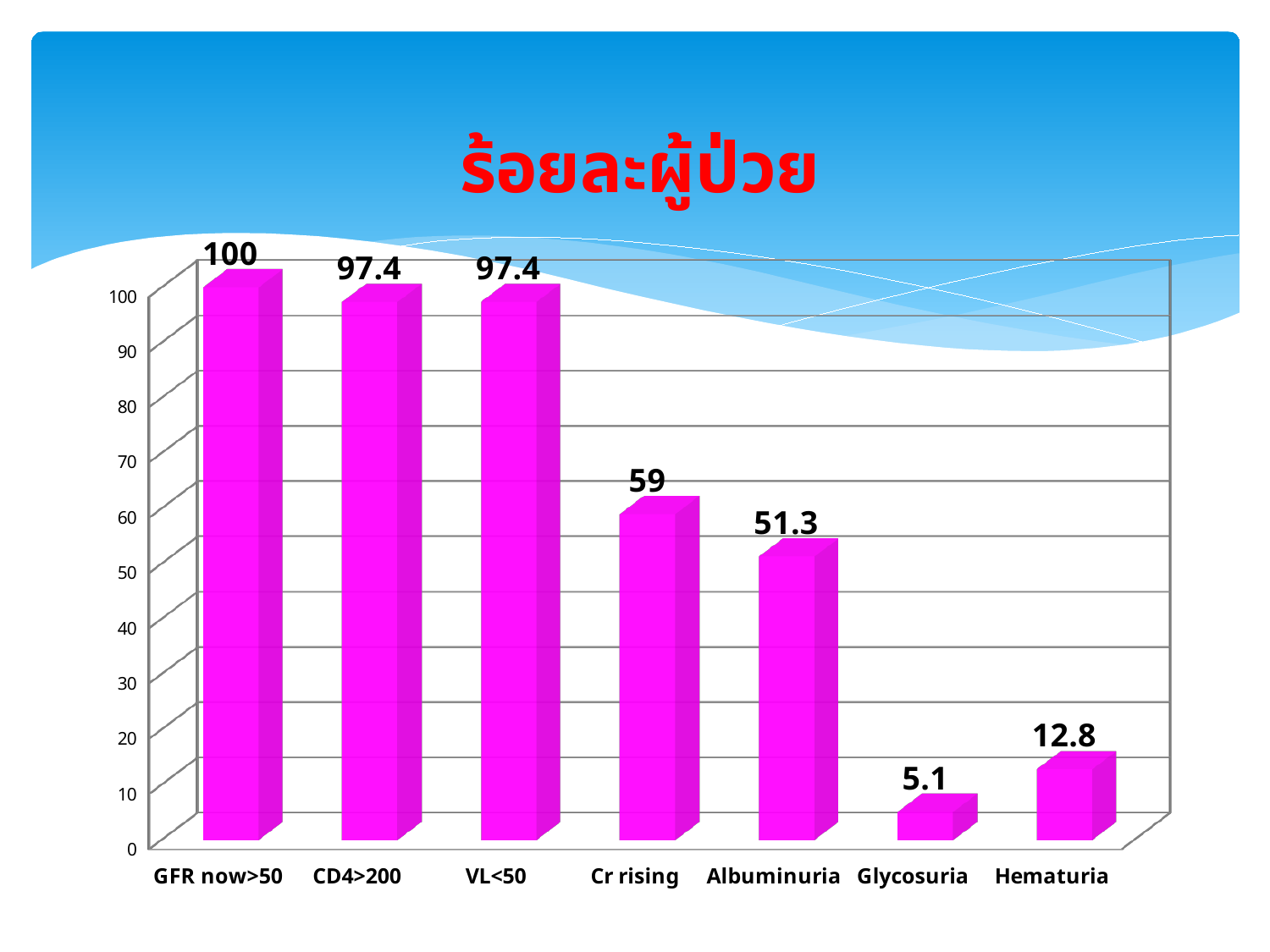
How many categories are shown on the x axis? 7 What is the value for Albuminuria? 51.3 Which is larger, the value for Hematuria or the value for Glycosuria? Hematuria What is the difference between the values for Hematuria and Glycosuria? 7.7 Which category has the lowest value? Glycosuria Which category has the highest value? GFR now>50 What is the value for Hematuria? 12.8 What is the value for CD4>200? 97.4 What is the value for Cr rising? 59 What kind of chart is shown on the slide? bar chart What colour are the bars in the chart? magenta What is the difference between the values for Cr rising and Albuminuria? 7.7